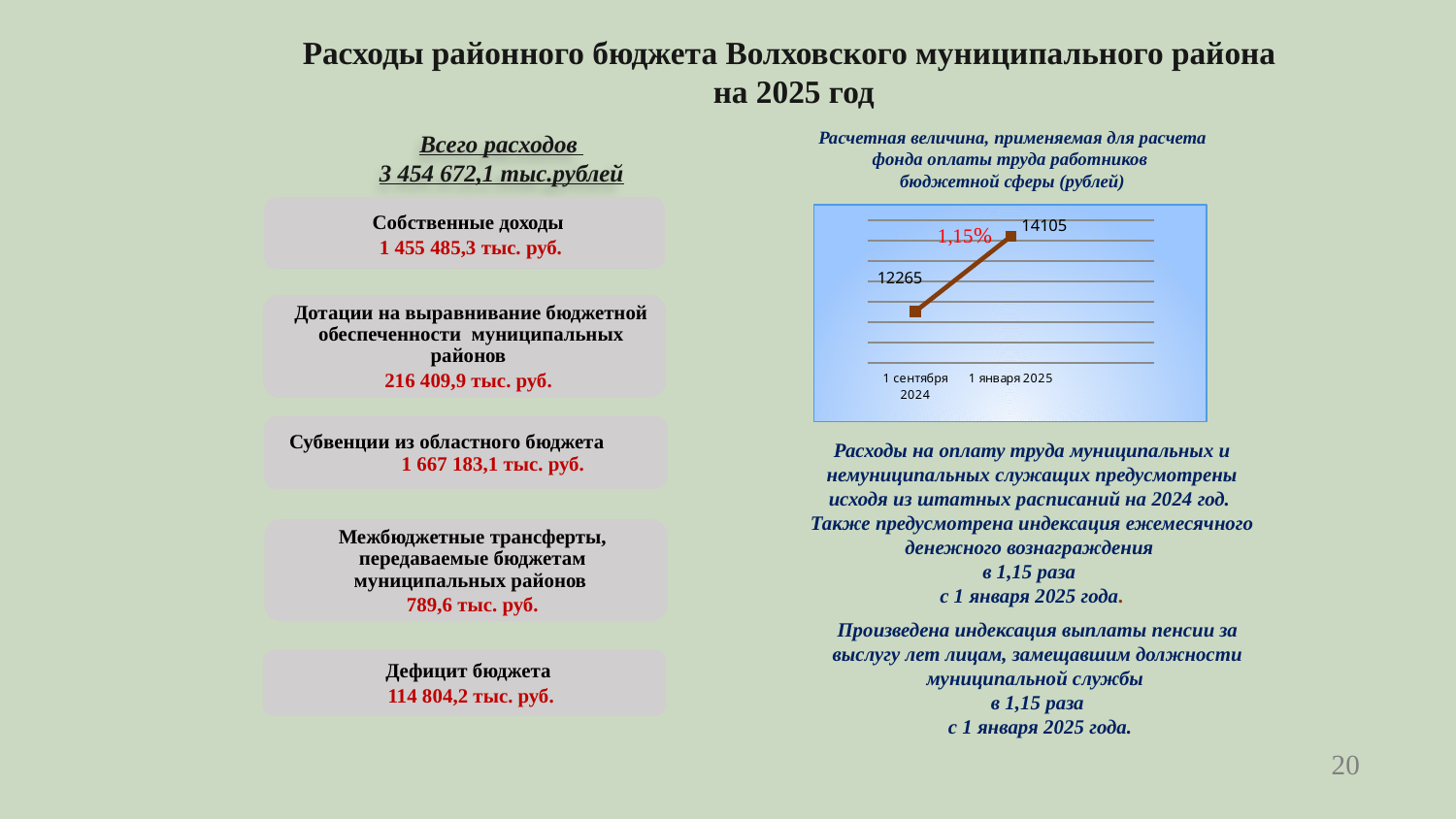
What unit is given in parentheses in the chart's title? рублей What percentage label is written next to the line on the chart? 1,15% What is the value for 1 января 2025 on the chart? 14105 Which date has the higher value on the chart? 1 января 2025 How many data points are plotted on the chart? 2 Which date has the lower value on the chart? 1 сентября 2024 What is the difference between the value for 1 января 2025 and the value for 1 сентября 2024? 1840 What kind of chart is shown on the slide? line chart Do the values rise or fall from 1 сентября 2024 to 1 января 2025? rise What is the value for 1 сентября 2024 on the chart? 12265 Is the value for 1 января 2025 larger or smaller than the value for 1 сентября 2024? larger